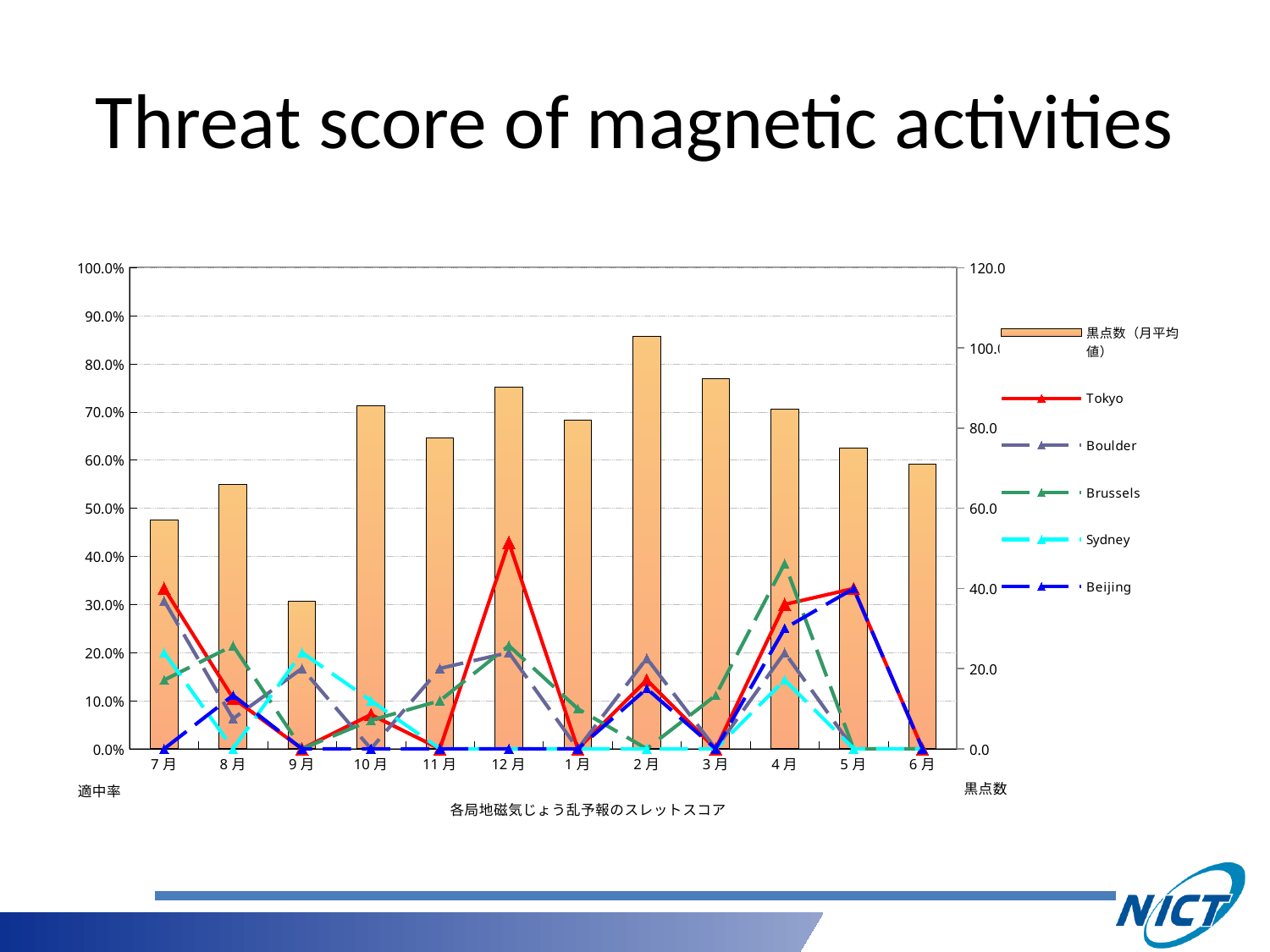
Is the Tokyo value for 12月 greater or less than 30.0%? greater Do the sunspot number bars rise or fall from 2月 to 6月? fall How many months are shown along the x axis? 12 In which month is the sunspot number (黒点数) bar the lowest? 9月 What kind of chart is shown on the slide? A combination bar and line chart Is the sunspot number bar for 9月 greater or less than 60.0 on the right axis? less What is the Tokyo value for 1月? 0.0% Is the sunspot number bar for 2月 greater or less than 80.0 on the right axis? greater Which has the taller sunspot number bar, 10月 or 11月? 10月 In which month is the sunspot number (黒点数) bar the highest? 2月 How many series does the legend list? 6 What colour is the Tokyo line in the legend? Red